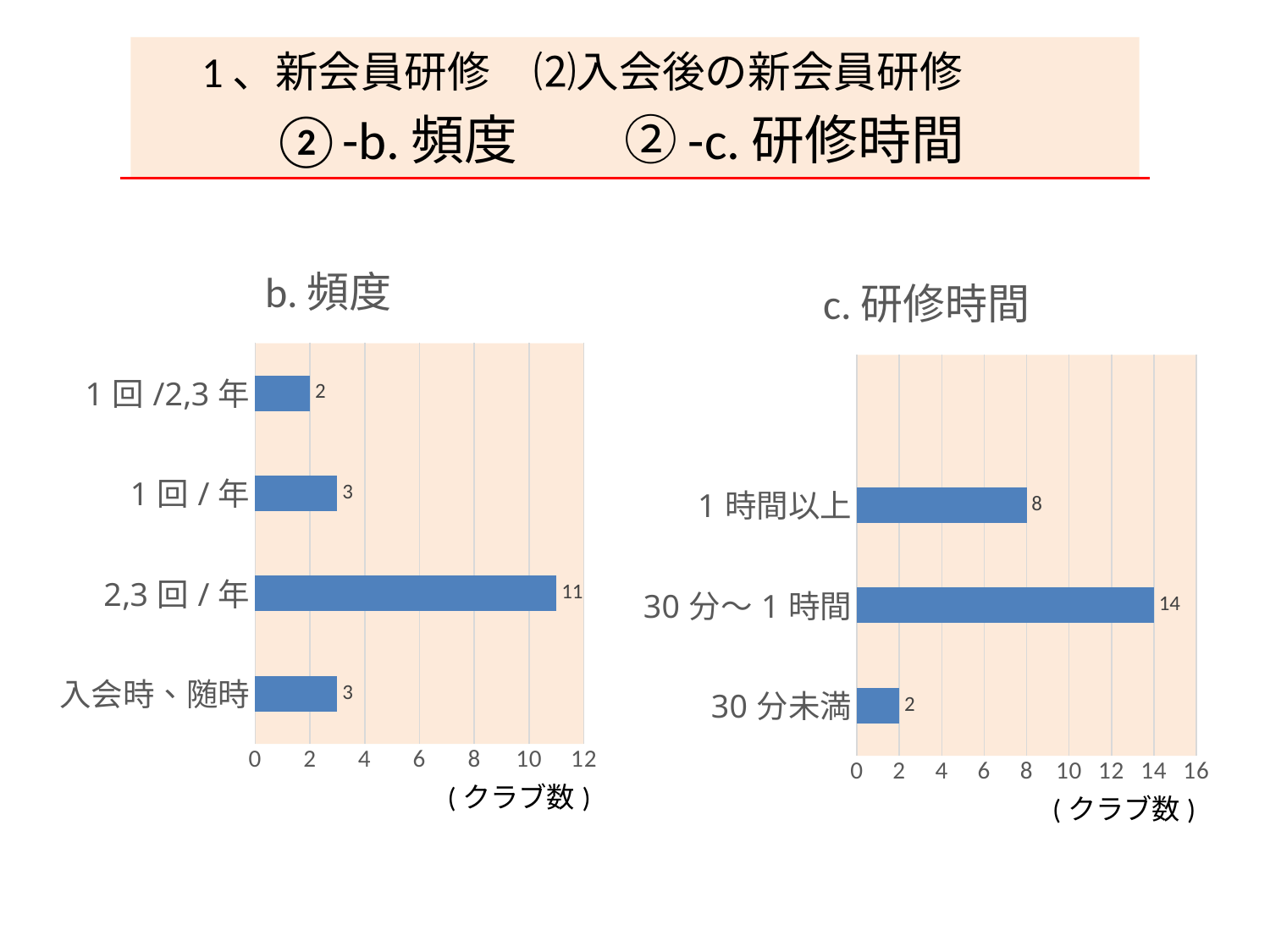
In the chart titled 'b. 頻度', what is the value for '2,3 回 / 年'? 11 In the chart titled 'b. 頻度', what is the difference between the values for '2,3 回 / 年' and '1 回 / 年'? 8 In the chart titled 'c. 研修時間', what is the difference between the values for '30 分〜 1 時間' and '30 分未満'? 12 In the chart titled 'c. 研修時間', which is larger, the value for '1 時間以上' or the value for '30 分未満'? 1 時間以上 In the chart titled 'c. 研修時間', what is the value for '1 時間以上'? 8 What kind of chart is the chart titled 'c. 研修時間'? bar chart In the chart titled 'c. 研修時間', which category has the lowest value? 30 分未満 In the chart titled 'b. 頻度', which category has the highest value? 2,3 回 / 年 In the chart titled 'b. 頻度', how many categories are shown? 4 In the chart titled 'b. 頻度', what is the value for '1 回 /2,3 年'? 2 In the chart titled 'c. 研修時間', what is the value for '30 分〜 1 時間'? 14 In the chart titled 'b. 頻度', which category has the lowest value? 1 回 /2,3 年